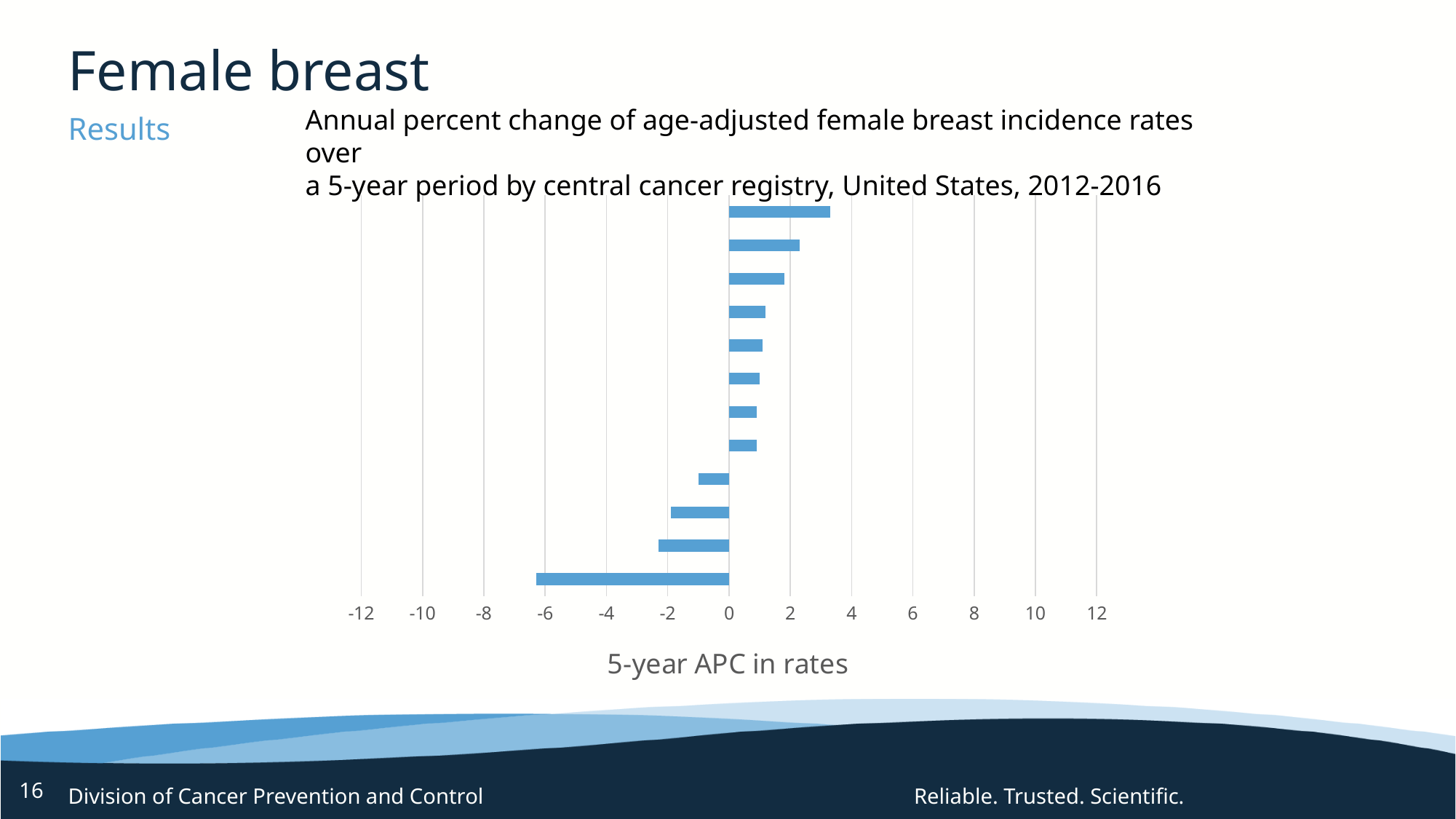
What kind of chart is shown on the slide? bar chart Is the value of the second bar from the bottom greater or less than -4? greater Is the value of the top bar in the chart greater or less than 2? greater Which bar has the lowest value: the top bar or the bottom bar? the bottom bar Is the value of the bottom bar in the chart greater or less than -4? less How many bars in the chart extend to the right of zero (positive values)? 8 What are the minimum and maximum tick labels shown on the horizontal axis? -12 and 12 How many bars are plotted in the chart? 12 How many bars in the chart extend to the left of zero (negative values)? 4 What is the title of the horizontal axis of the chart? 5-year APC in rates